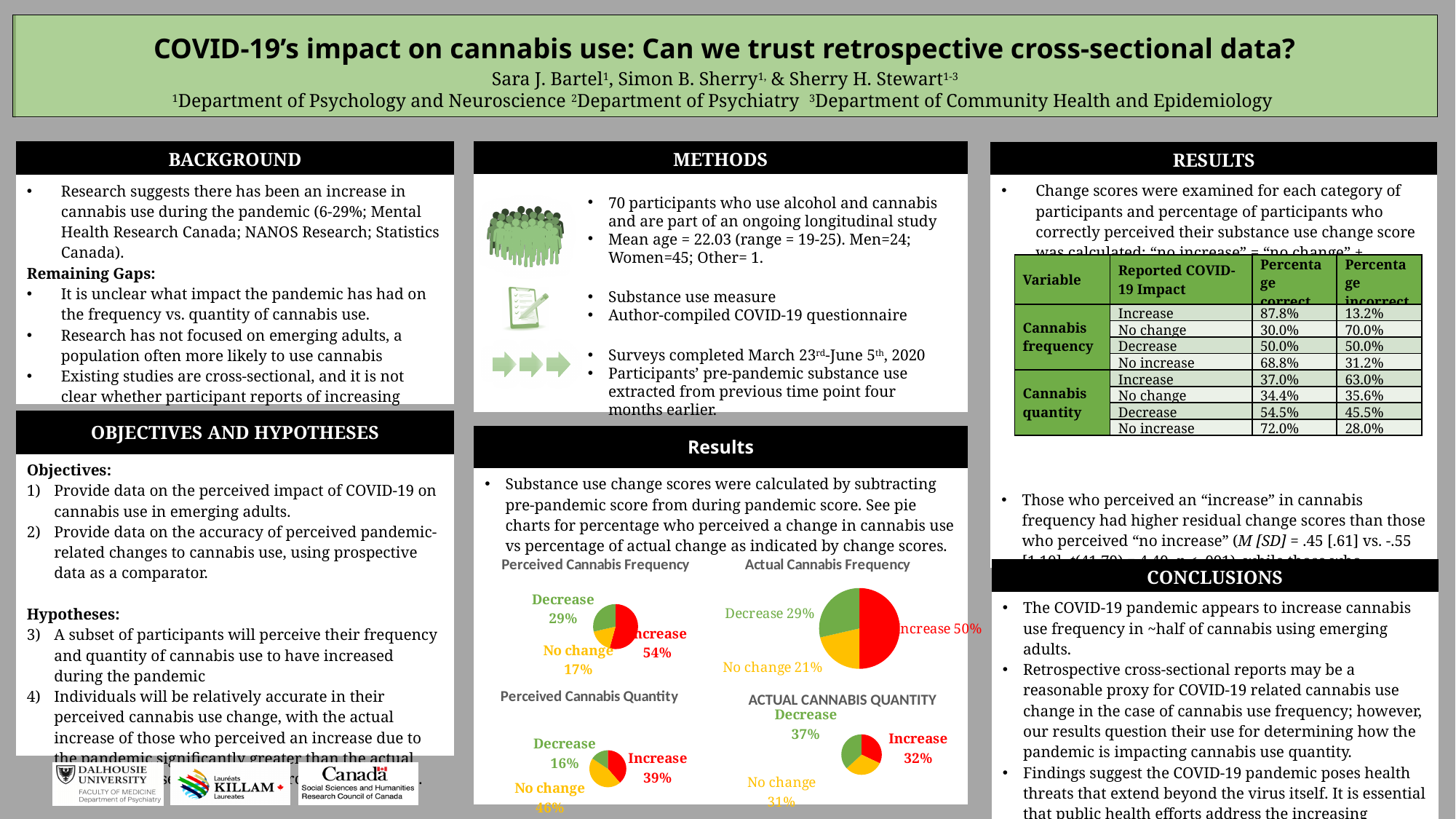
In the Actual Cannabis Quantity pie chart, what percentage showed a decrease? 37% In the Perceived Cannabis Frequency pie chart, which category has the smallest share? No change In the Actual Cannabis Quantity pie chart, which category has the largest share? Decrease In the Perceived Cannabis Frequency pie chart, which category has the largest share? Increase In the Perceived Cannabis Frequency pie chart, what percentage of participants perceived an increase? 54% How many slices does the Actual Cannabis Frequency pie chart have? 3 Which is larger: the Decrease share in the Perceived Cannabis Quantity chart or the Decrease share in the Actual Cannabis Quantity chart? Actual Cannabis Quantity In the Actual Cannabis Frequency pie chart, what percentage showed no change? 21% What type of chart is used to show Perceived Cannabis Frequency? Pie chart What is the difference between the Increase share in the Perceived Cannabis Frequency chart and the Increase share in the Actual Cannabis Frequency chart? 4% In the Perceived Cannabis Quantity pie chart, what percentage of participants perceived an increase? 39% How many pie charts are shown in the Results section of the slide? 4